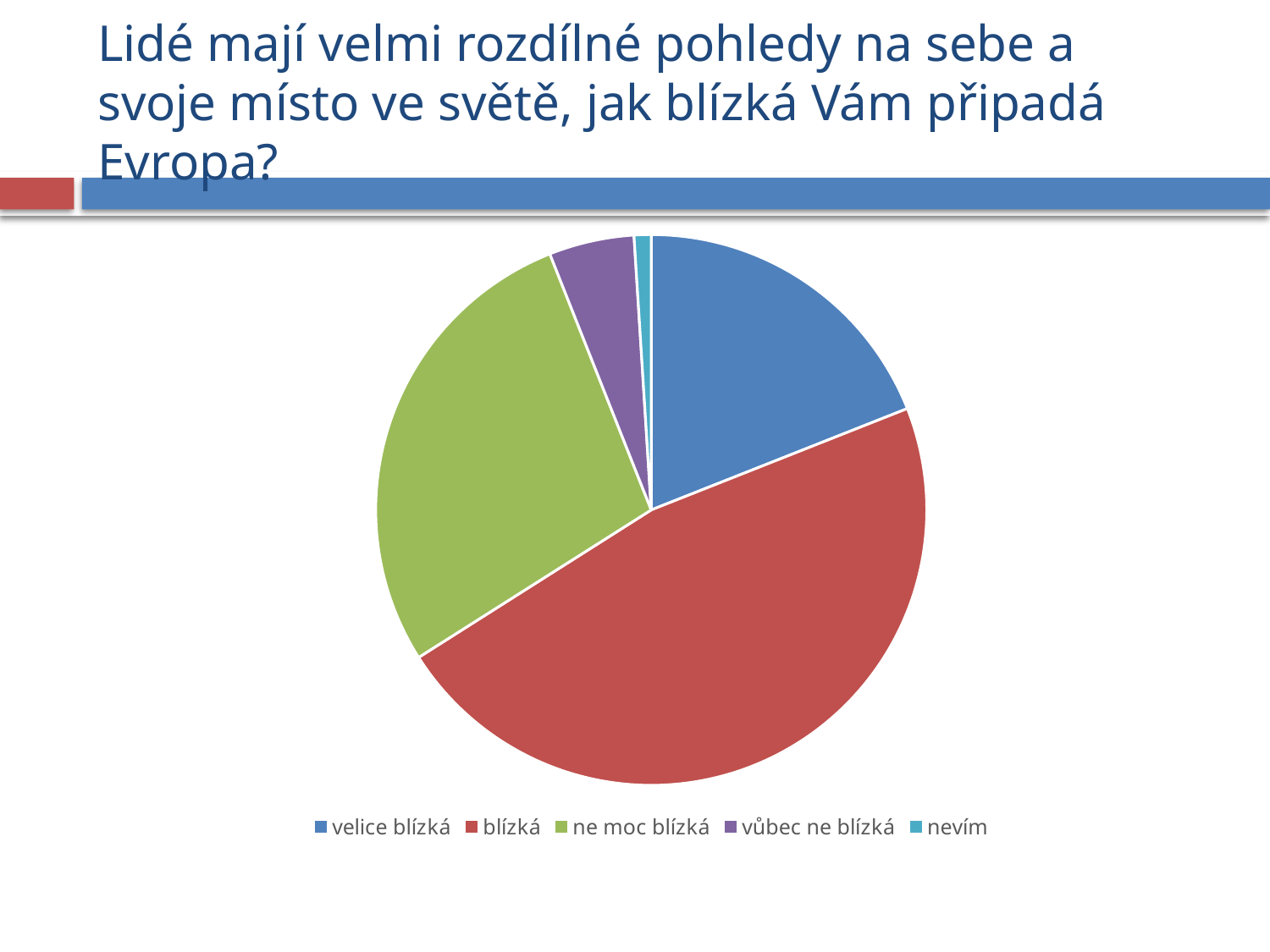
Which slice is larger, "vůbec ne blízká" or "nevím"? vůbec ne blízká Which category has the smallest slice of the pie? nevím What kind of chart is shown on the slide? pie chart Which slice is larger, "velice blízká" or "ne moc blízká"? ne moc blízká How many slices does the pie chart have? 5 Which slice is larger, "ne moc blízká" or "vůbec ne blízká"? ne moc blízká What colour is the slice for "ne moc blízká"? green How many entries does the legend list? 5 Which category is shown in red in the pie chart? blízká Which category has the largest slice of the pie? blízká